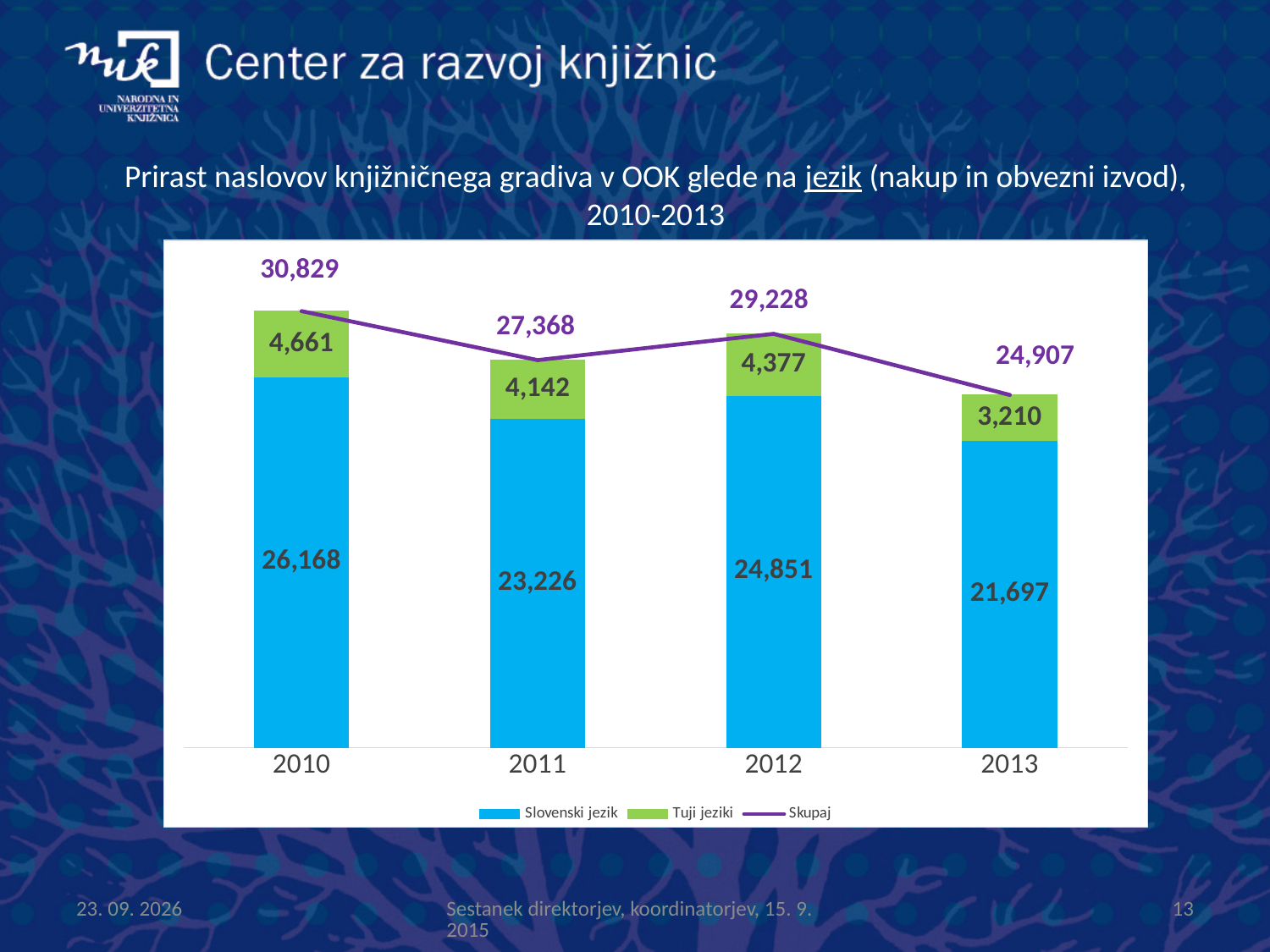
What is the Skupaj value for 2012? 29,228 Which is larger, the Tuji jeziki value for 2010 or for 2012? 2010 Which colour represents Tuji jeziki in the legend? Green What is the value for Tuji jeziki in 2013? 3,210 What kind of chart is this? Stacked bar chart with a line What is the total of the stacked bar for 2011? 27,368 How many years are shown on the x axis? 4 What is the value for Slovenski jezik in 2010? 26,168 What is the difference between the Slovenski jezik values for 2012 and 2011? 1,625 How many series does the legend list? 3 Which year has the lowest value for Tuji jeziki? 2013 Which year has the highest Skupaj value? 2010